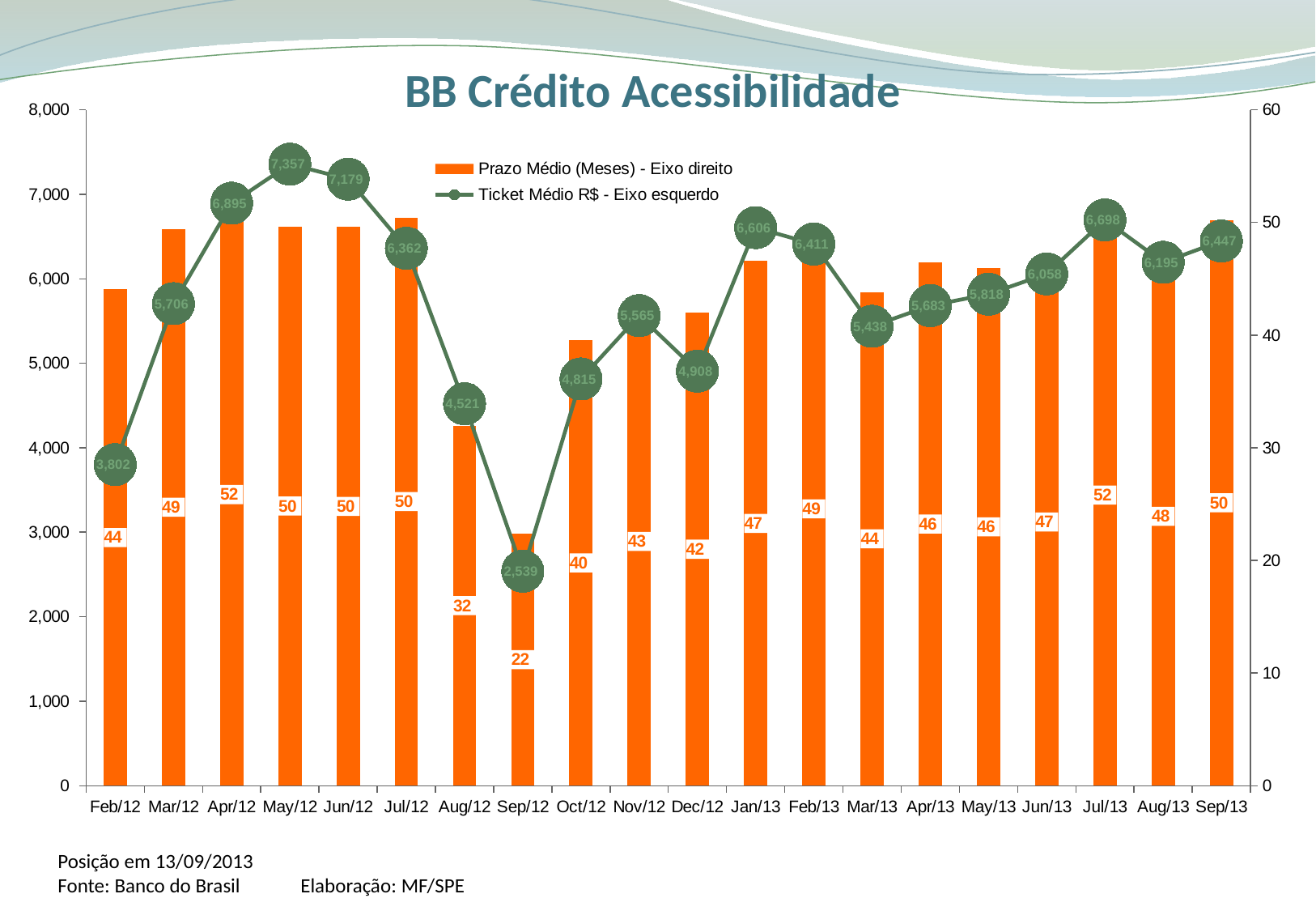
Which month has the lowest Prazo Médio (Meses) value? Sep/12 What is the title of the chart? BB Crédito Acessibilidade What is the difference between the Prazo Médio (Meses) values for Jul/12 and Aug/12? 18 Which month has the highest Ticket Médio R$ value? May/12 How many series does the legend list? 2 How many months are shown on the x axis? 20 What is the Prazo Médio (Meses) value for Sep/12? 22 What is the Ticket Médio R$ value for Sep/13? 6,447 What is the difference between the Ticket Médio R$ values for Jul/13 and Aug/13? 503 Which is larger, the Ticket Médio R$ value for Jan/13 or for Feb/13? Jan/13 Which month has the lowest Ticket Médio R$ value? Sep/12 What is the Ticket Médio R$ value for May/12? 7,357